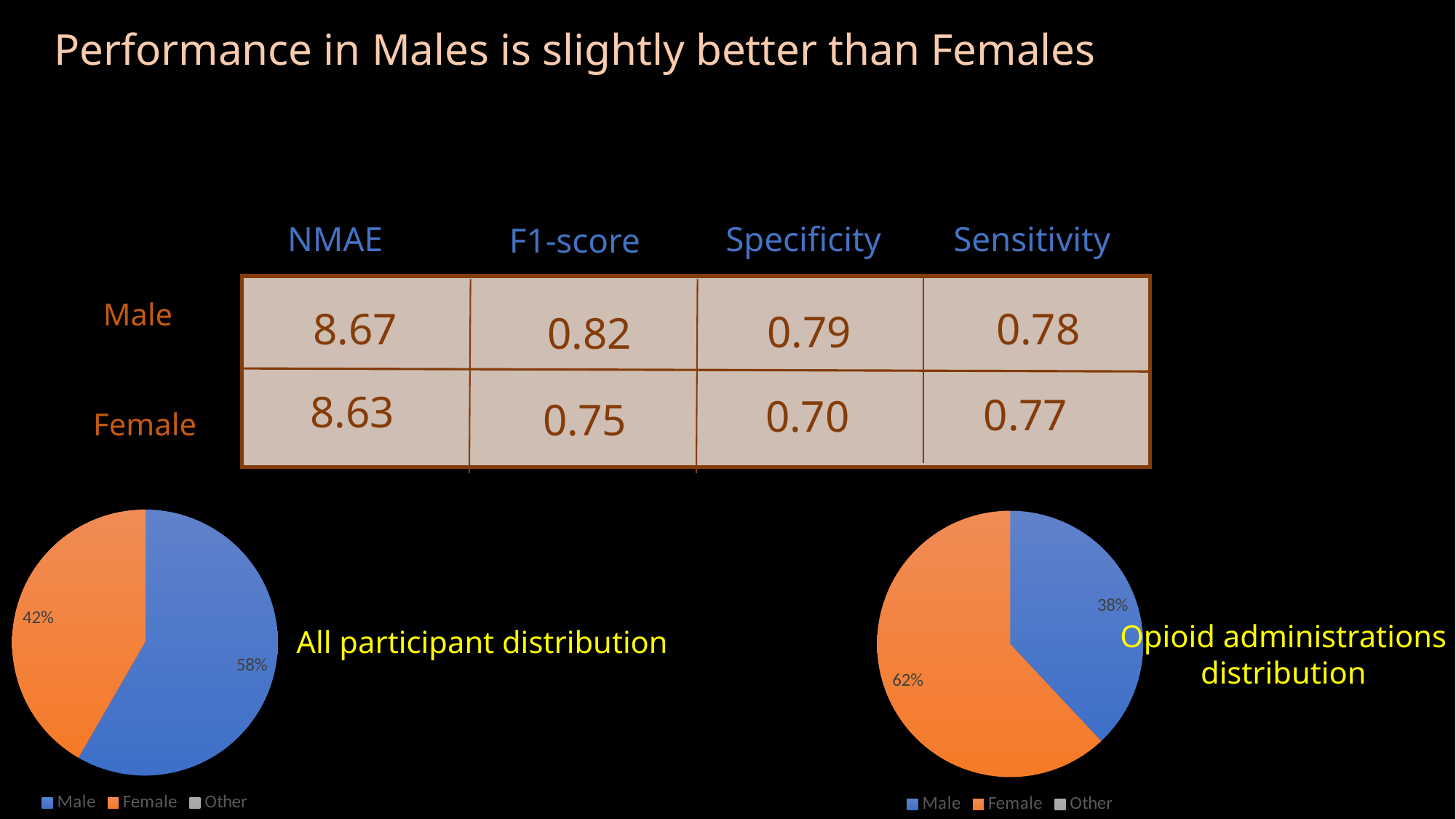
In the 'Opioid administrations distribution' pie chart, what share is Female? 62% How many entries does the legend of the 'Opioid administrations distribution' pie chart list? 3 In the 'All participant distribution' pie chart, what share is Male? 58% What type of chart is 'All participant distribution'? pie chart In the 'Opioid administrations distribution' pie chart, what share is Male? 38% In the 'Opioid administrations distribution' pie chart, what is the difference between the Female and Male shares? 24% In the 'All participant distribution' pie chart, what share is Female? 42% In the 'Opioid administrations distribution' pie chart, is the Male slice larger or smaller than the Female slice? smaller In the 'All participant distribution' pie chart, what is the difference between the Male and Female shares? 16% In the 'All participant distribution' pie chart, which category has the largest slice? Male In the 'All participant distribution' pie chart, what colour is the Female slice? orange In the 'Opioid administrations distribution' pie chart, which category has the largest slice? Female